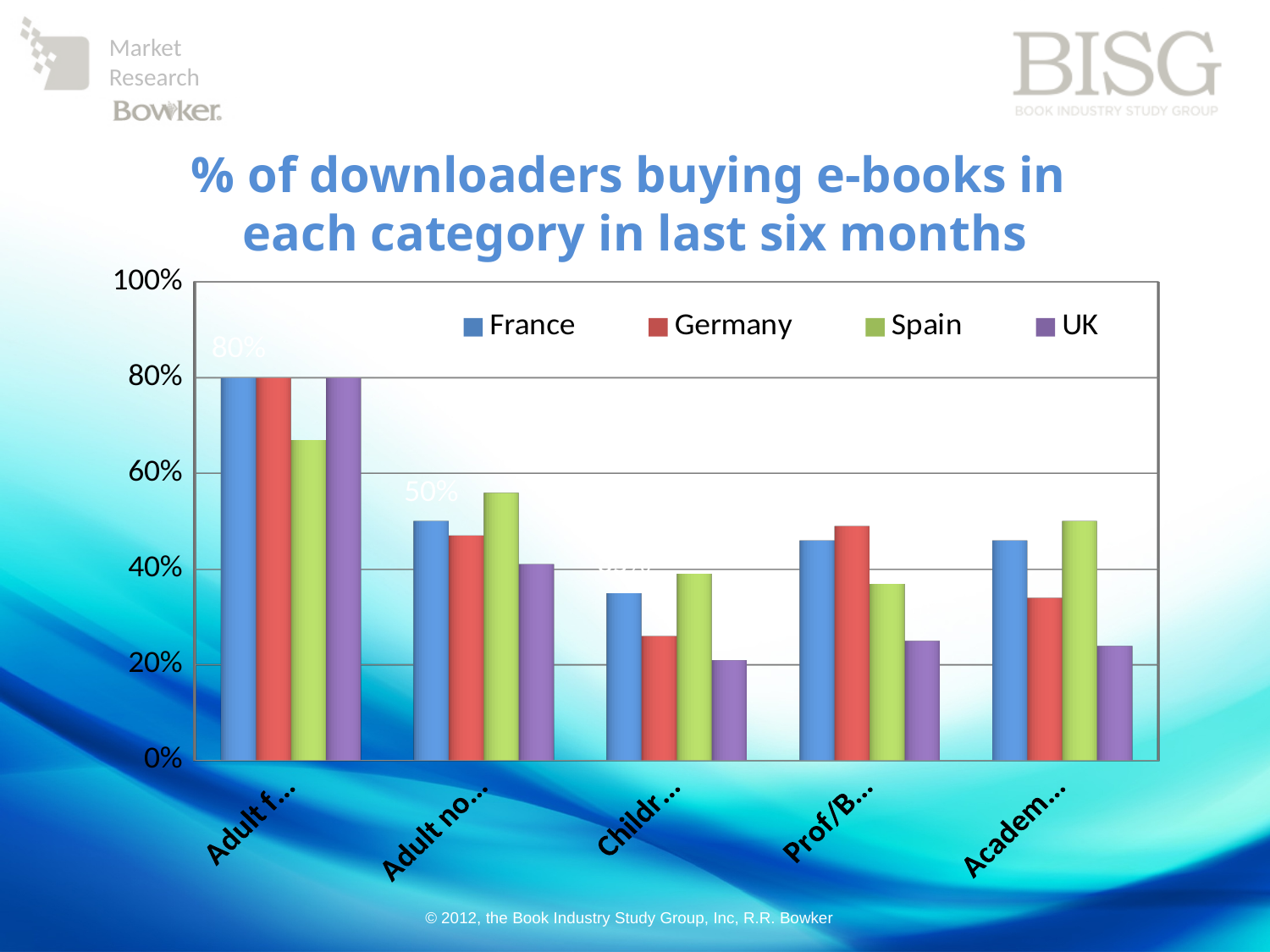
Which series is shown in green in the legend? Spain In the "Childr…" group, which is larger: Spain or Germany? Spain In the "Prof/B…" group, which is larger: Germany or UK? Germany What is the value for France in the second category group ("Adult no…")? 50% Is the value for Spain in the "Adult f…" group greater or less than 60%? greater What kind of chart is shown on the slide? bar chart What is the difference between the France value for "Adult f…" and the France value for "Adult no…"? 30% In the "Academ…" group, which series has the lowest value? UK How many series does the legend list? 4 What is the value for France in the first category group ("Adult f…")? 80% Is the value for UK in the "Childr…" group greater or less than 40%? less How many category groups are plotted along the x axis? 5